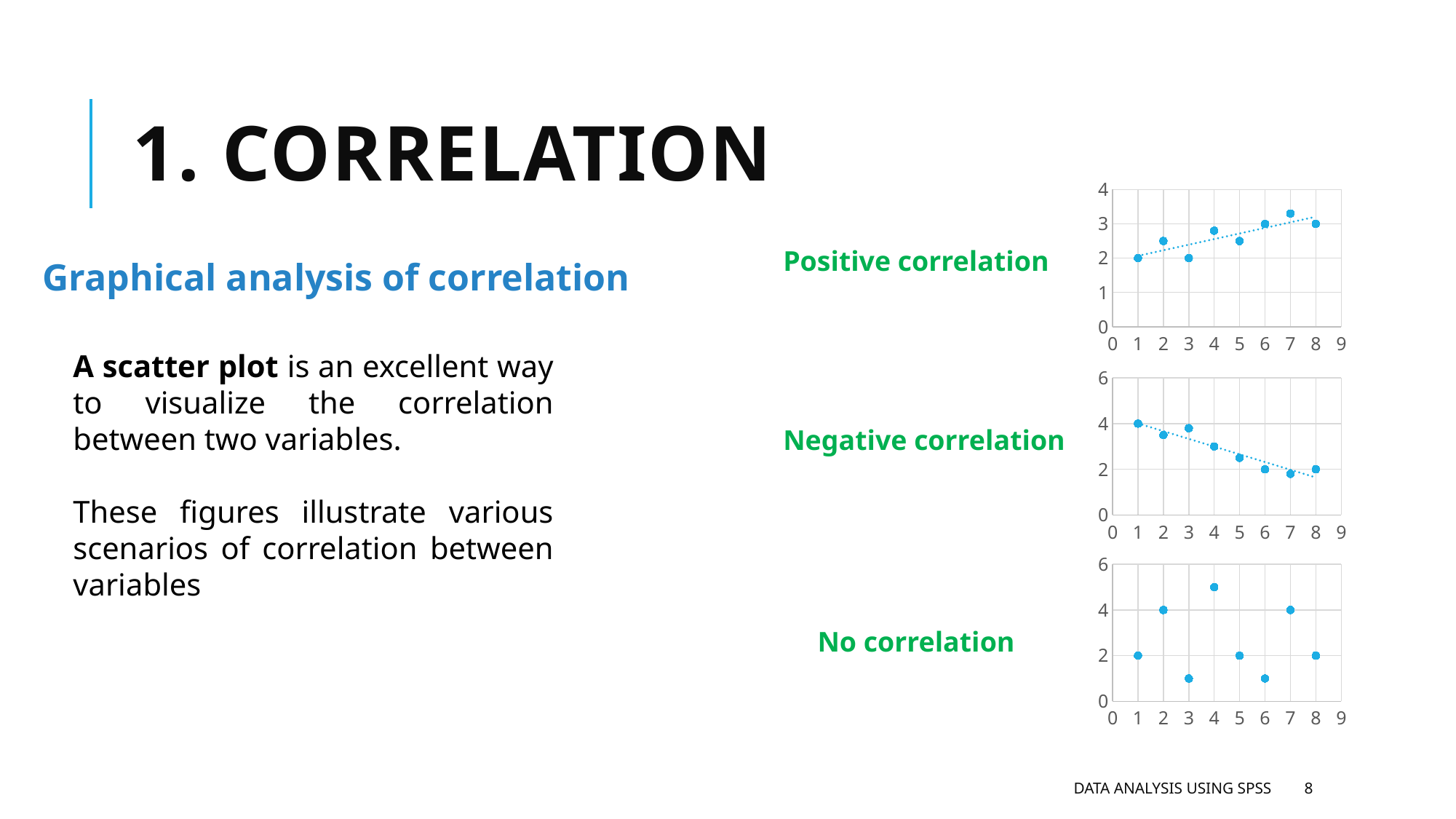
In the No correlation chart, what is the y value at x = 8? 2 How many data points are plotted in the No correlation chart? 8 What kind of chart is the Positive correlation chart? scatter plot In the No correlation chart, is the y value at x = 4 greater or less than 4? greater In the Negative correlation chart, what is the y value at x = 1? 4 In the No correlation chart, at which x value is the y value highest? 4 In the Positive correlation chart, do the values generally rise or fall as x increases? rise What are the labels of the three scatter plots on the slide, from top to bottom? Positive correlation, Negative correlation, No correlation In the No correlation chart, what is the y value at x = 2? 4 In the Positive correlation chart, what is the y value at x = 6? 3 In the Negative correlation chart, do the values generally rise or fall as x increases? fall